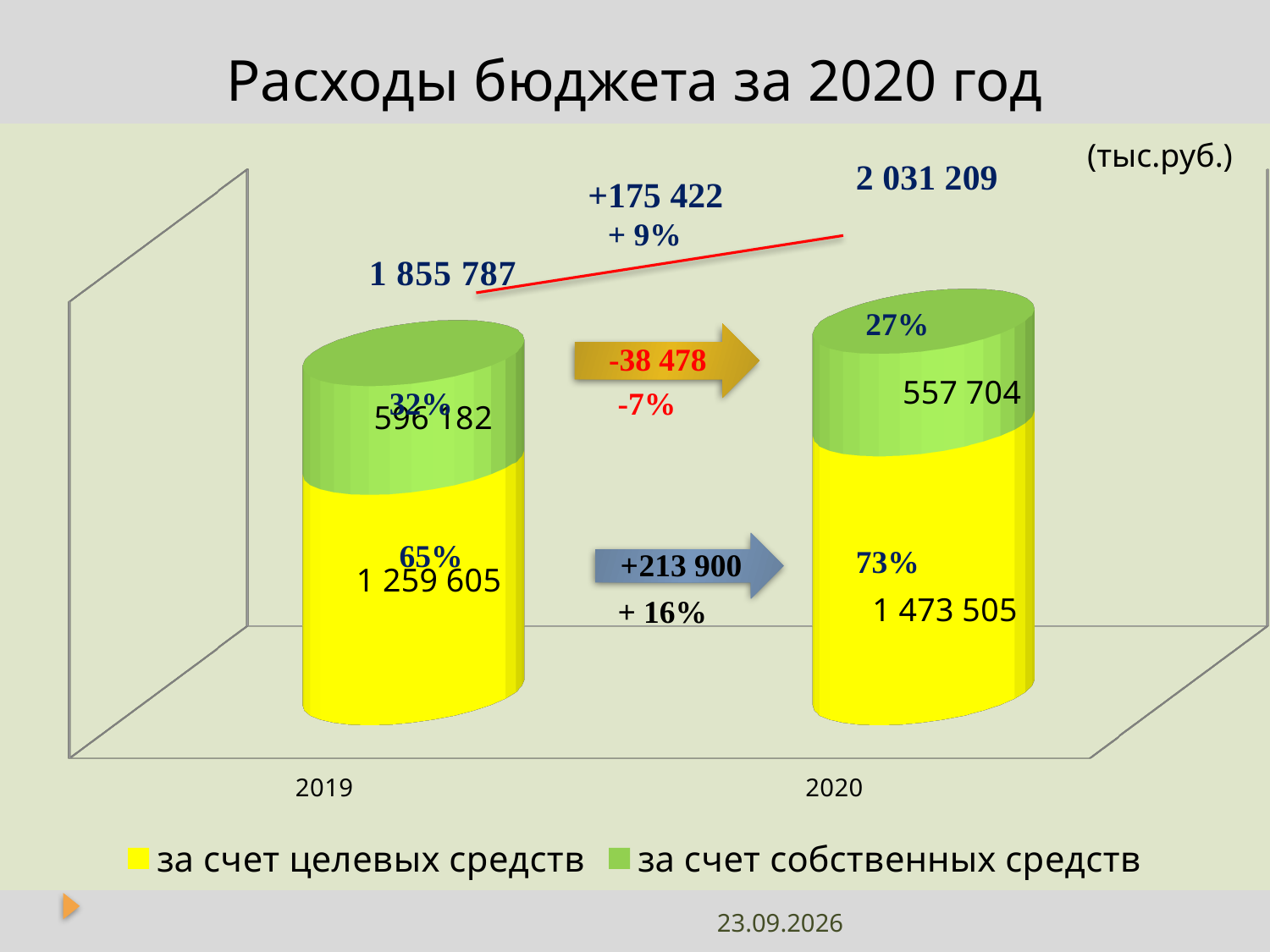
What is the value for 'за счет целевых средств' in 2019? 1 259 605 What is the total of the stacked bar for 2020? 2 031 209 What is the title of the chart? Расходы бюджета за 2020 год What is the value for 'за счет собственных средств' in 2019? 596 182 What is the total of the stacked bar for 2019? 1 855 787 What is the value for 'за счет собственных средств' in 2020? 557 704 What is the value for 'за счет целевых средств' in 2020? 1 473 505 Which year has the lower value for 'за счет собственных средств'? 2020 Which year has the higher value for 'за счет целевых средств', 2019 or 2020? 2020 How many series does the legend list? 2 What is the difference between the 'за счет целевых средств' values for 2020 and 2019? 213 900 What kind of chart is shown on the slide? Stacked bar chart